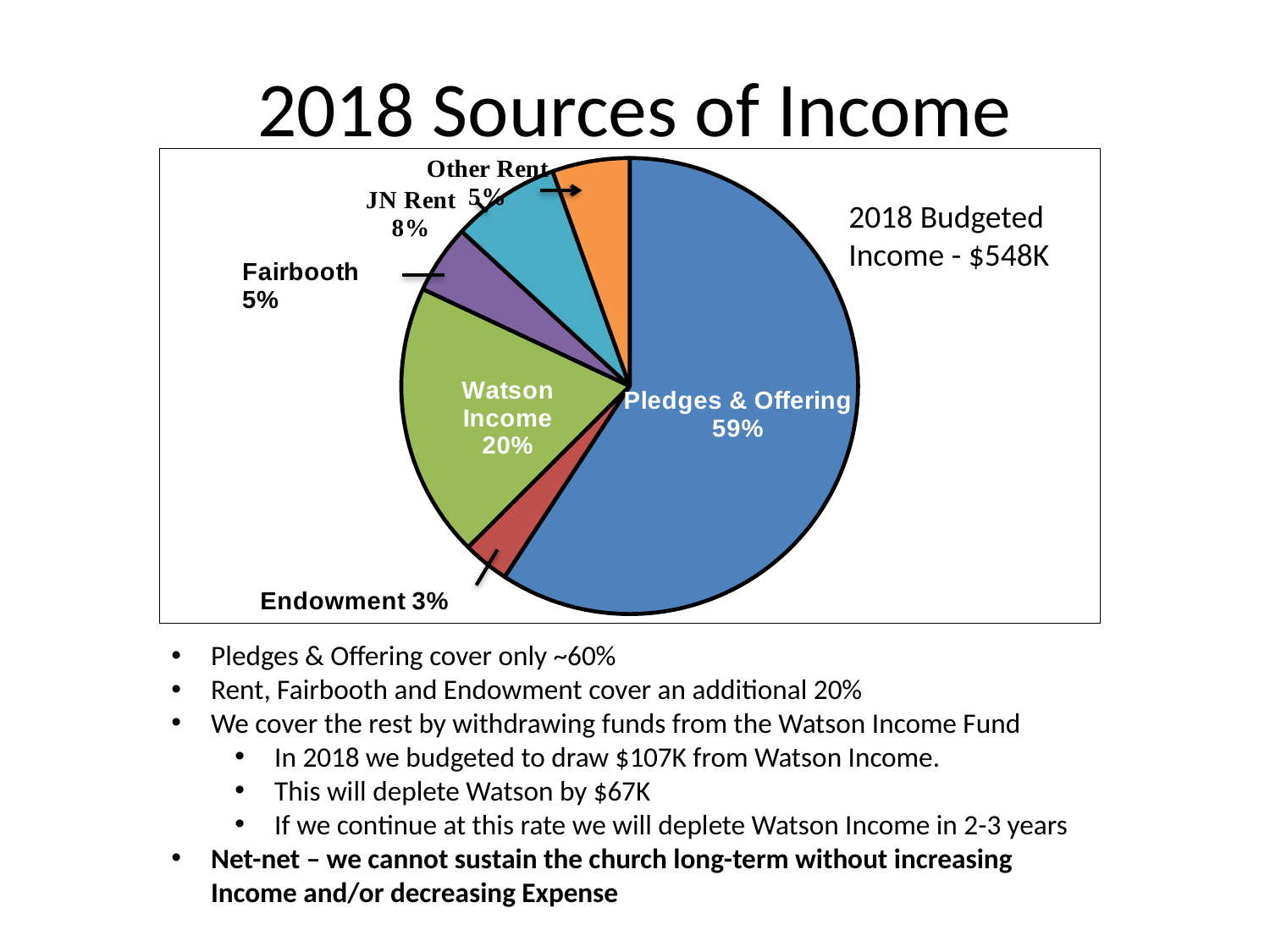
Which source of income has the largest slice of the pie? Pledges & Offering What total 2018 budgeted income is stated next to the pie chart? $548K Which is larger, the JN Rent slice or the Other Rent slice? JN Rent What share of 2018 income comes from Pledges & Offering? 59% What percentage of income is labelled for JN Rent? 8% How many slices does the pie chart have? 6 What kind of chart is shown on the slide? Pie chart What percentage of income is labelled for Fairbooth? 5% What is the difference in percentage points between Pledges & Offering and Watson Income? 39 Which source of income has the smallest slice of the pie? Endowment What percentage of income is labelled for Endowment? 3% What share of 2018 income comes from Watson Income? 20%